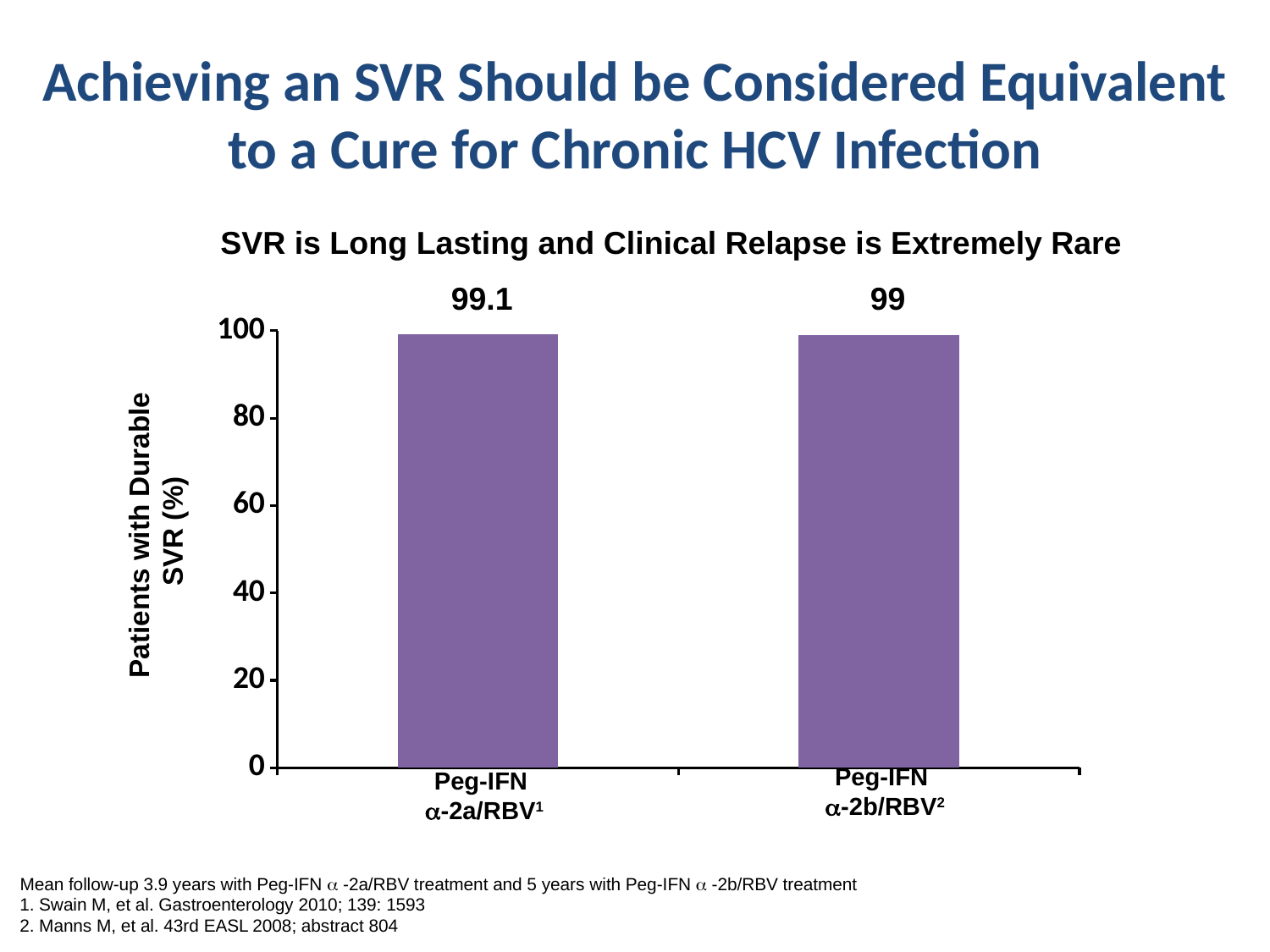
What is the title of the chart? SVR is Long Lasting and Clinical Relapse is Extremely Rare What is the highest value shown on the vertical axis? 100 What is the difference between the values for Peg-IFN α-2a/RBV and Peg-IFN α-2b/RBV? 0.1 Is the value for Peg-IFN α-2a/RBV greater or less than 60? greater What kind of chart is shown on the slide? bar chart How many bars are plotted in the chart? 2 What is the value for Peg-IFN α-2b/RBV? 99 What is the value for Peg-IFN α-2a/RBV? 99.1 Is the value for Peg-IFN α-2b/RBV greater or less than 80? greater What is the label of the vertical axis? Patients with Durable SVR (%) Which category has the higher value according to the data labels, Peg-IFN α-2a/RBV or Peg-IFN α-2b/RBV? Peg-IFN α-2a/RBV